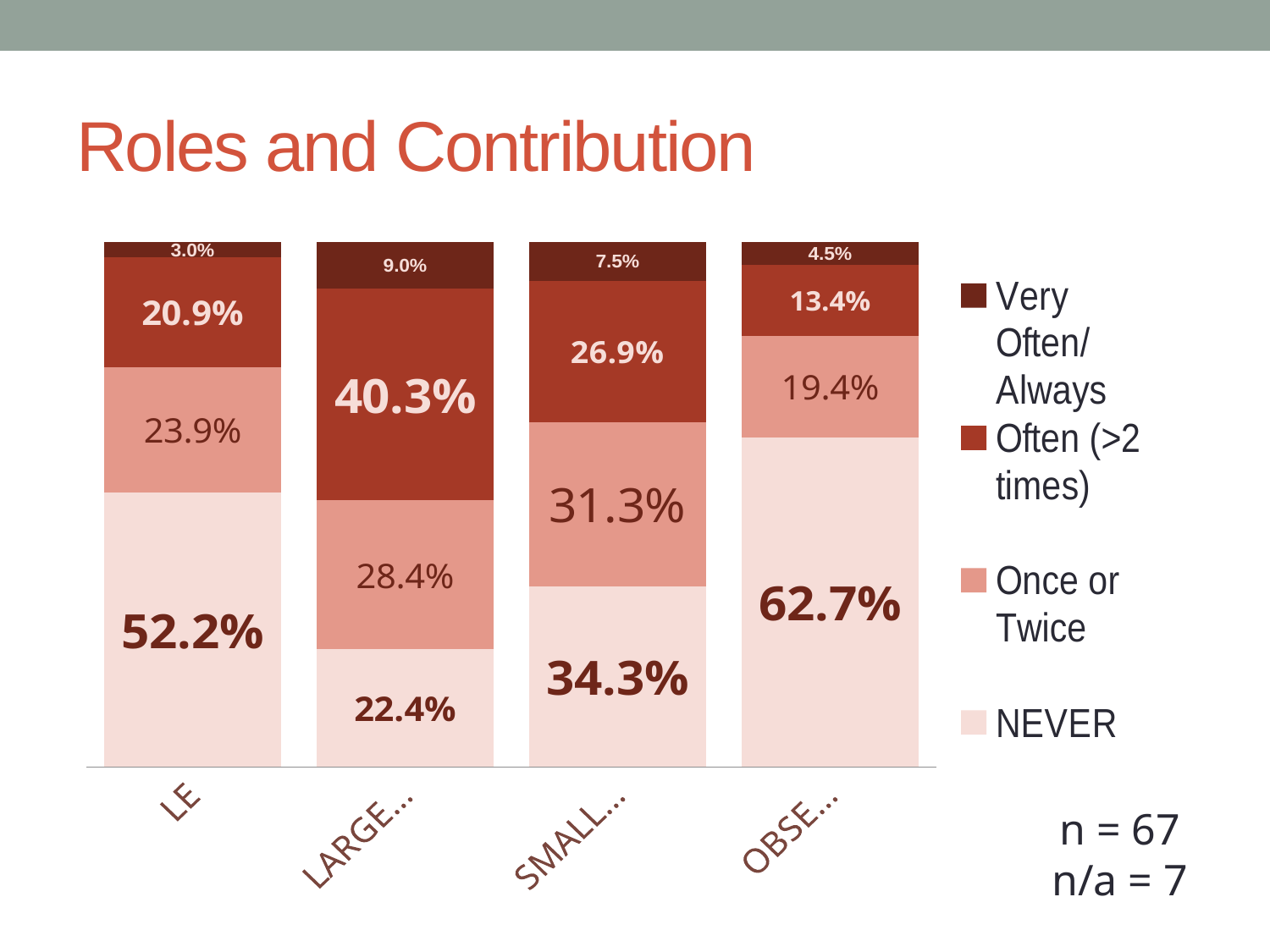
What is the total of all segments in the LE bar? 100.0% What kind of chart is shown on the slide? Stacked bar chart What sample size (n) is stated on the slide? n = 67 How many series does the legend list? 4 Which is larger: the Once or Twice value for LE or the Once or Twice value for the third bar (SMALL…)? SMALL… (31.3%) Which bar has the lowest Very Often/Always value? LE What is the Very Often/Always value for the third bar from the left (SMALL…)? 7.5% How many bars (categories) are plotted in the chart? 4 Which bar has the highest NEVER value? OBSE… (fourth bar from the left) What is the NEVER value for the LE bar? 52.2% What is the difference between the NEVER value of the fourth bar (OBSE…) and the NEVER value of the LE bar? 10.5 percentage points What is the Often (>2 times) value for the second bar from the left (LARGE…)? 40.3%